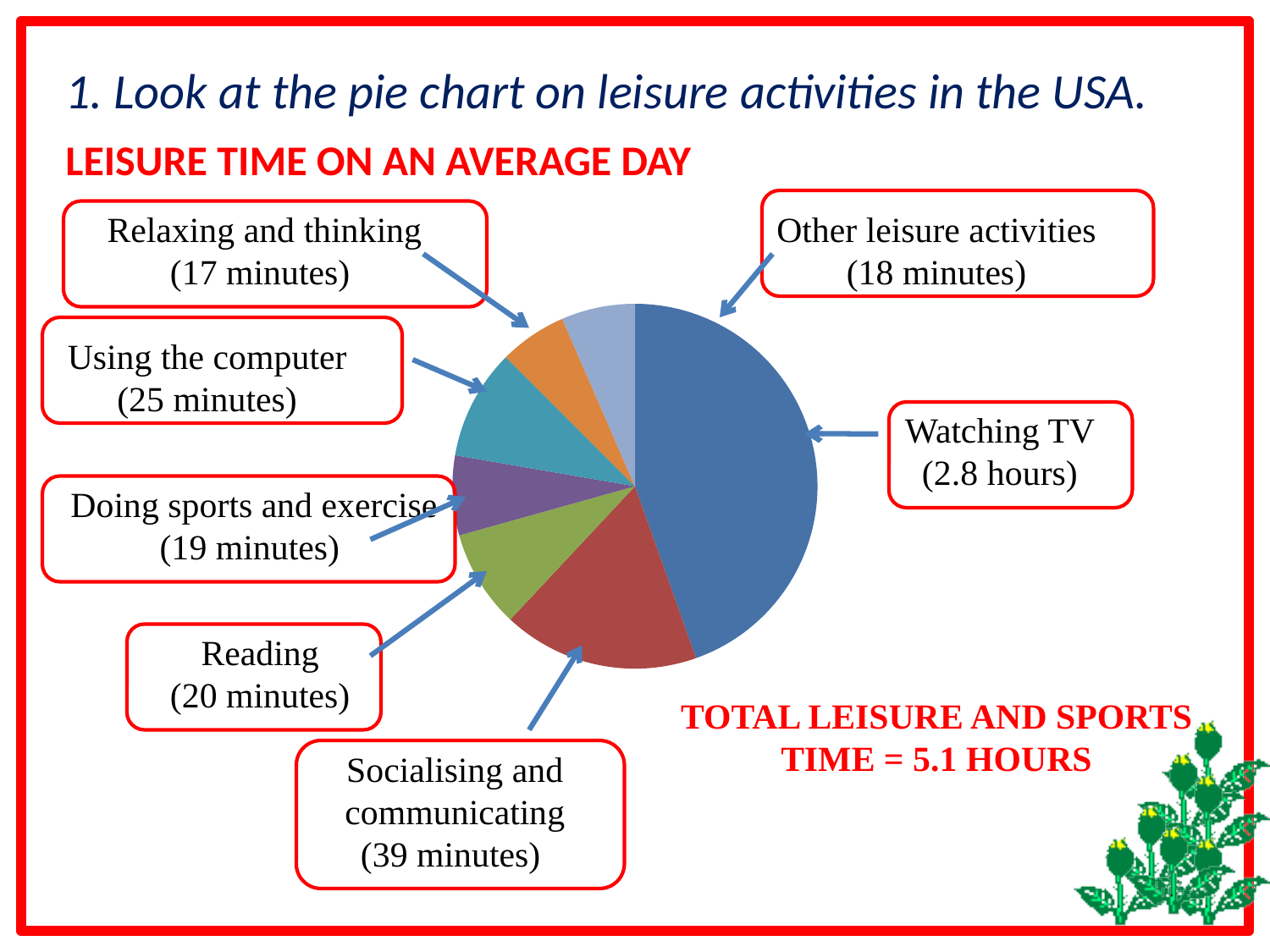
How many slices does the pie chart have? 7 What kind of chart is shown on the slide? pie chart What is the title of the chart? LEISURE TIME ON AN AVERAGE DAY Which activity takes up the largest share of leisure time? Watching TV How much time is spent using the computer? 25 minutes How much time is spent on other leisure activities? 18 minutes How much time is spent socialising and communicating? 39 minutes How many more minutes are spent socialising and communicating than reading? 19 minutes What is the total leisure and sports time stated on the slide? 5.1 hours Which activity takes up the least leisure time? Relaxing and thinking How much time is spent watching TV on an average day? 2.8 hours Which takes more time: using the computer or doing sports and exercise? Using the computer